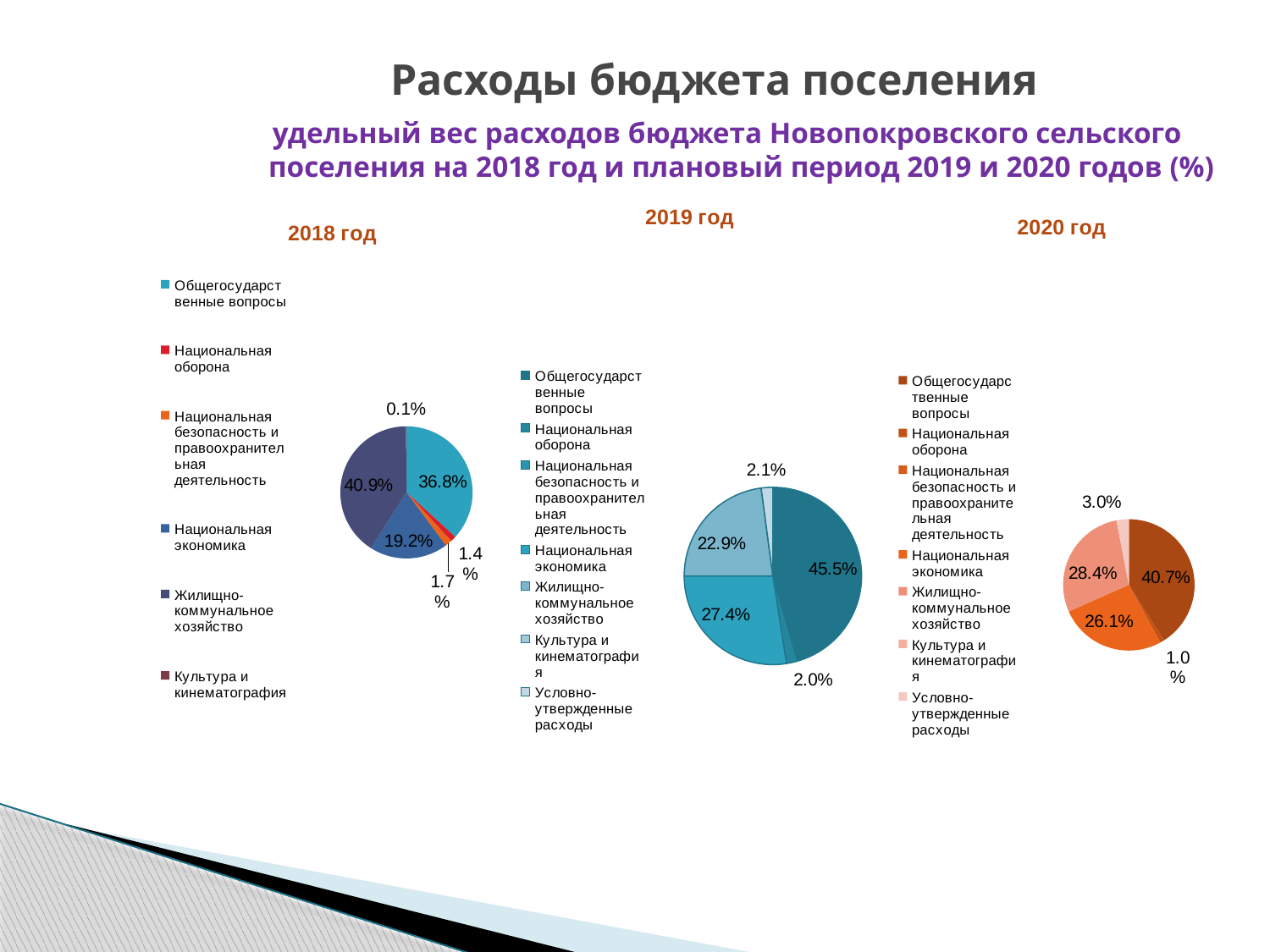
In the 2018 год chart, what is the share of Национальная экономика? 19.2% How many categories does the legend of the 2019 год chart list? 7 How many categories does the legend of the 2018 год chart list? 6 In the 2019 год chart, what is the share of Общегосударственные вопросы? 45.5% In the 2019 год chart, what is the share of Жилищно-коммунальное хозяйство? 22.9% In the 2020 год chart, what is the share of Общегосударственные вопросы? 40.7% Which is larger: the share of Общегосударственные вопросы in the 2018 год chart or in the 2020 год chart? 2020 год In the 2018 год chart, what is the share of Общегосударственные вопросы? 36.8% In the 2018 год chart, what is the largest slice's value? 40.9% What kind of chart is used for the 2018 год data? pie chart In the 2020 год chart, what is the difference between the 28.4% slice and the 26.1% slice? 2.3 percentage points In the 2018 год chart, what is the smallest slice's value? 0.1%